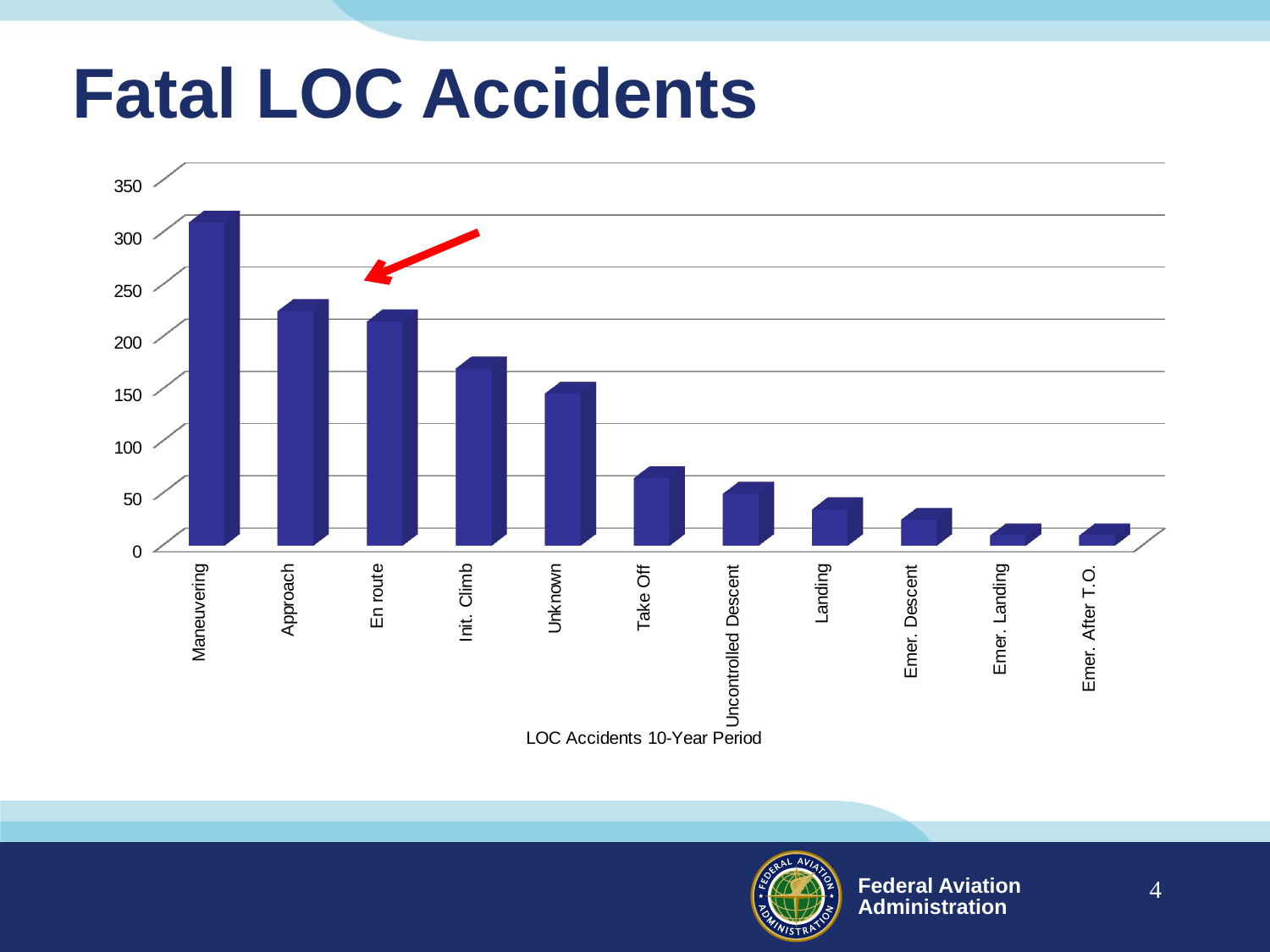
Is the value for Init. Climb greater or less than 150? greater Is the value for Landing greater or less than 50? less What kind of chart is shown on the slide? Bar chart Which is larger, the value for Init. Climb or the value for Unknown? Init. Climb Is the value for Take Off greater or less than 100? less What is the label shown beneath the x axis of the chart? LOC Accidents 10-Year Period Do the values rise or fall moving from left to right along the x axis? Fall Which category has the highest number of fatal LOC accidents? Maneuvering Which is larger, the value for Take Off or the value for Landing? Take Off How many categories are shown on the x axis of the chart? 11